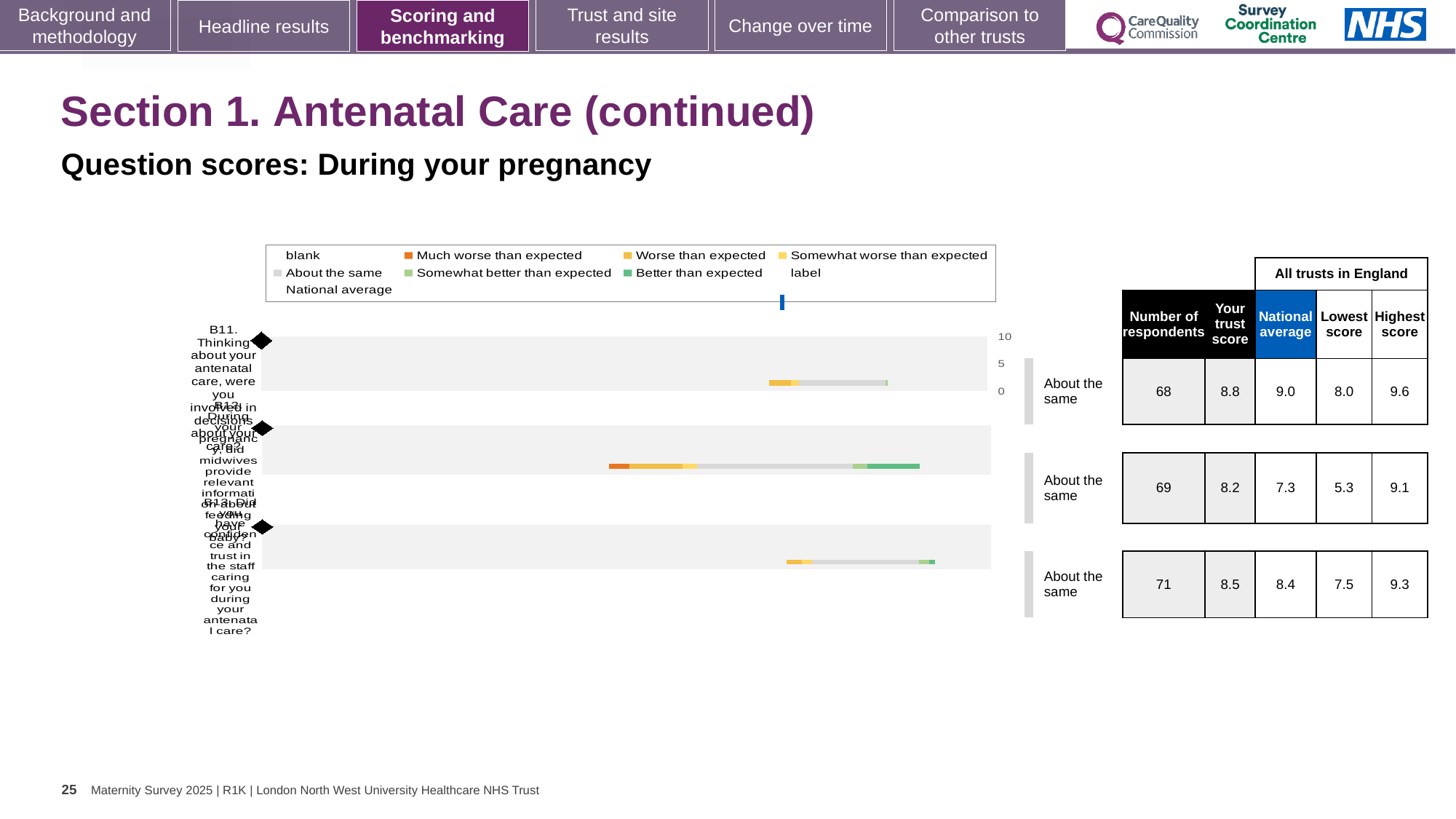
Which question has the lowest national average? B12 Which question has the highest 'Your trust score'? B11 What kind of chart is shown on the slide? bar chart How many respondents answered question B13 (confidence and trust in the staff caring for you)? 71 For question B12, how much higher is the trust score than the national average? 0.9 What is the national average for question B12 (midwives provide relevant information about feeding your baby)? 7.3 What is the 'Your trust score' for question B11 (involved in decisions about your care)? 8.8 How many entries does the chart legend list? 9 What benchmark category is shown next to each of the three questions? About the same What is the highest score across all trusts in England for question B11? 9.6 How many questions (categories) are plotted in the chart? 3 For question B13, which is larger: the trust score or the national average? the trust score